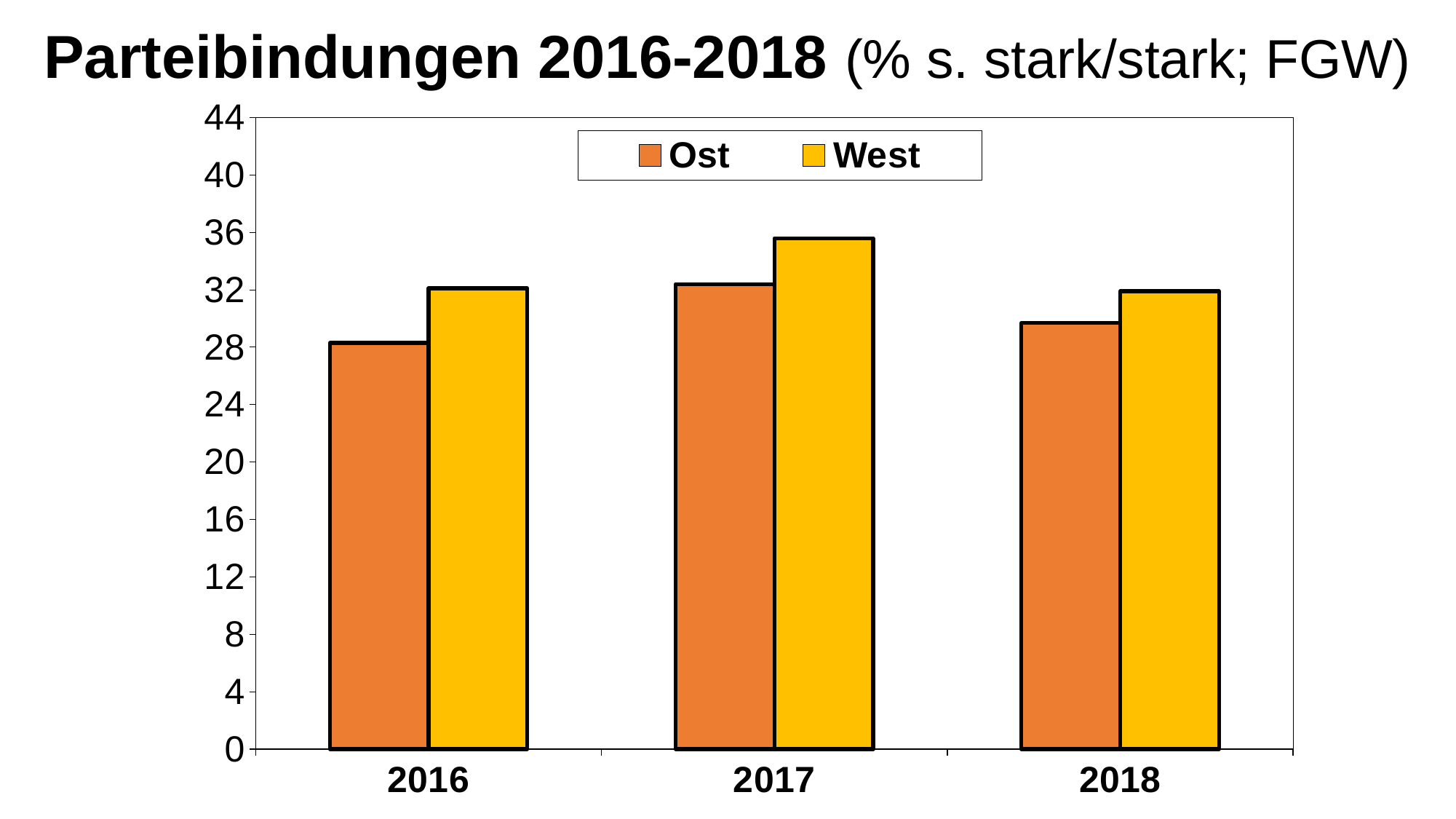
Is the West value for 2017 greater or less than 32? greater Which colour represents the Ost series in the legend? orange Which is larger, the Ost value for 2017 or the Ost value for 2018? 2017 Does the West value rise or fall from 2017 to 2018? fall What kind of chart is shown on the slide? bar chart Which year has the lowest Ost value? 2016 Is the Ost value for 2016 greater or less than 32? less In 2016, which is larger, the Ost value or the West value? West How many years are shown on the x axis? 3 How many series does the legend list? 2 In 2018, which is larger, the Ost value or the West value? West Which year has the highest West value? 2017